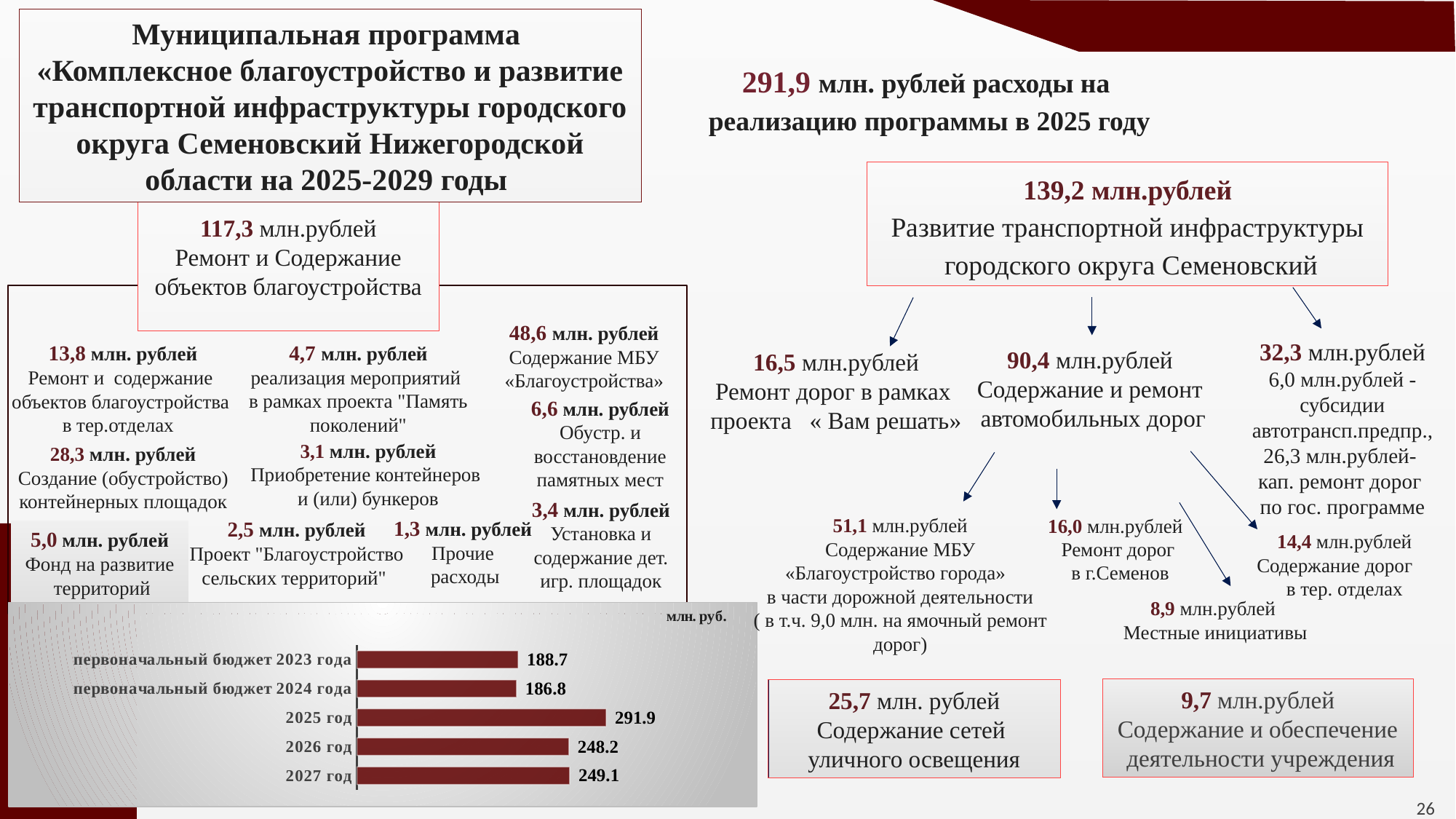
In the bar chart, which category has the lowest value? первоначальный бюджет 2024 года In the bar chart, which category has the highest value? 2025 год In the bar chart, what is the value for первоначальный бюджет 2023 года? 188.7 How many bars are shown in the bar chart? 5 In the bar chart, what is the value for 2025 год? 291.9 In the bar chart, what is the difference between the values for первоначальный бюджет 2023 года and первоначальный бюджет 2024 года? 1.9 What unit is indicated in the top right corner of the bar chart? млн. руб. What type of chart is shown at the bottom left of the slide? bar chart In the bar chart, what is the difference between the values for 2025 год and 2026 год? 43.7 In the bar chart, what is the value for первоначальный бюджет 2024 года? 186.8 In the bar chart, which is larger: the value for 2026 год or the value for первоначальный бюджет 2023 года? 2026 год In the bar chart, what is the value for 2027 год? 249.1